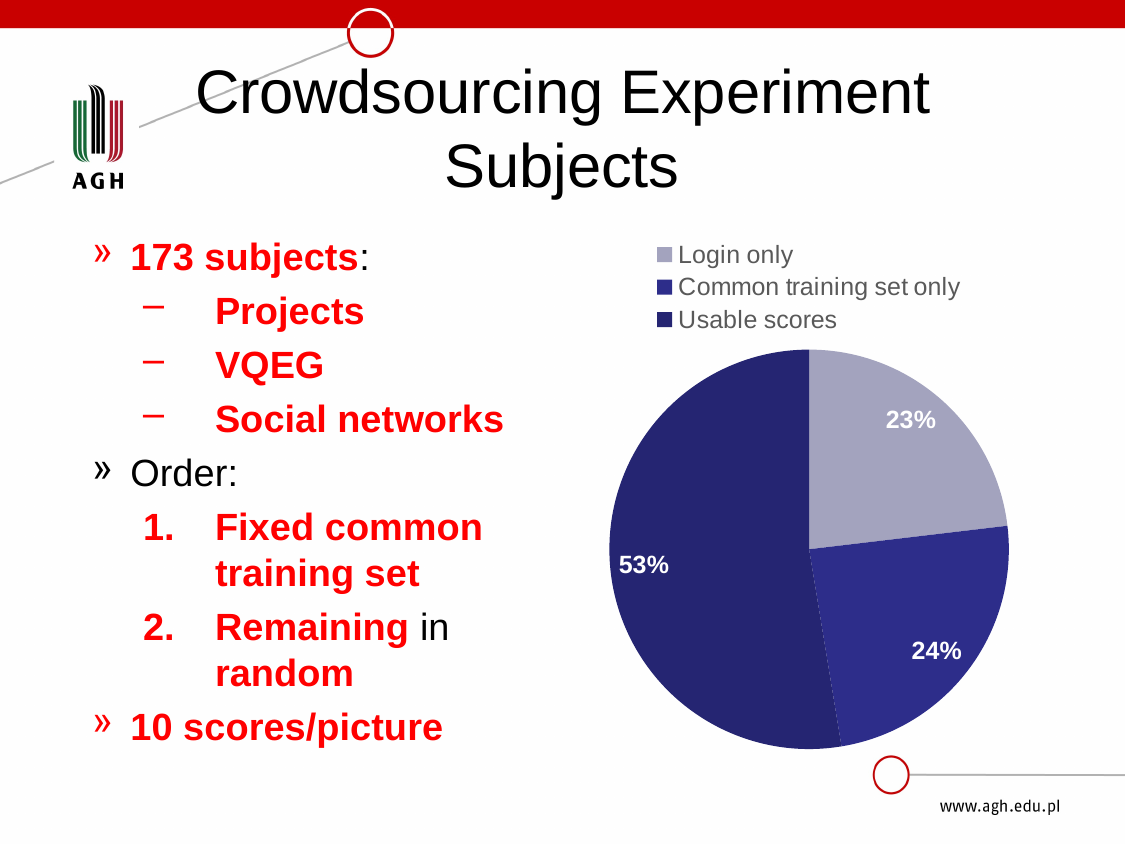
What is the combined share of the "Login only" and "Common training set only" slices? 47% What is the difference in percentage points between the "Usable scores" slice and the "Login only" slice? 30 What share of the pie does the "Usable scores" slice represent? 53% Which category has the largest slice of the pie? Usable scores What kind of chart is shown on the slide? pie chart Which is larger, the "Usable scores" slice or the "Common training set only" slice? Usable scores What share of the pie does the "Login only" slice represent? 23% How many slices does the pie chart have? 3 Which legend entry is shown in the lightest colour in the pie chart? Login only How many entries does the legend of the pie chart list? 3 What share of the pie does the "Common training set only" slice represent? 24% Which category has the smallest slice of the pie? Login only